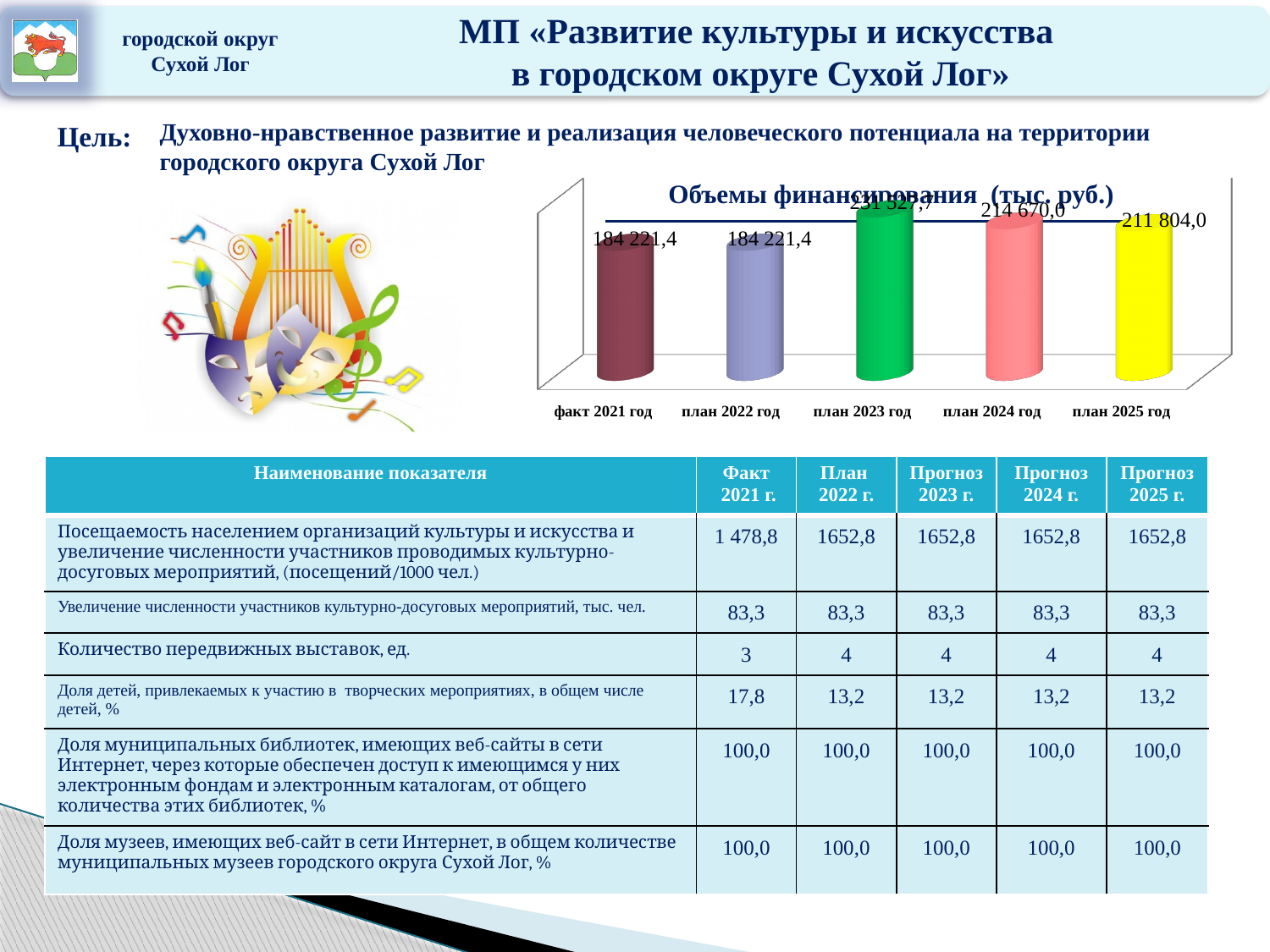
Which is larger, the value for план 2024 год or план 2025 год? план 2024 год What is the value for план 2022 год in the chart? 184 221,4 What is the value for факт 2021 год in the chart? 184 221,4 Which category has the highest value in the chart? план 2023 год Does the value rise or fall from план 2024 год to план 2025 год? fall What is the difference between the values for план 2025 год and план 2022 год? 27 582,6 How many categories are shown in the chart? 5 What is the value for план 2025 год in the chart? 211 804,0 What is the title of the chart? Объемы финансирования (тыс. руб.) What is the value for план 2024 год in the chart? 214 670,0 What kind of chart is shown on the slide? bar chart What is the difference between the values for план 2024 год and план 2025 год? 2 866,0